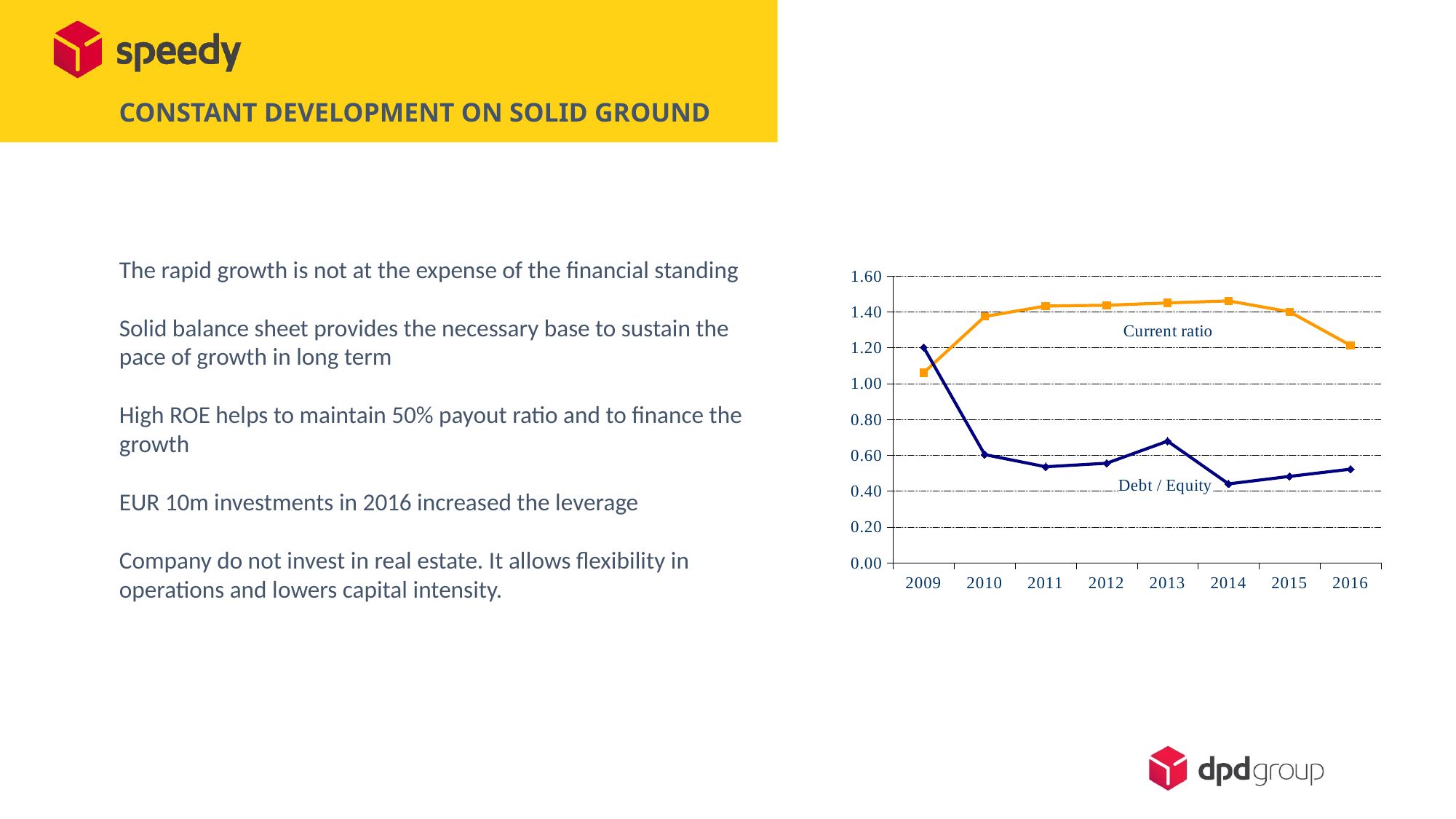
Does the Current ratio rise or fall from 2014 to 2016? Fall Is the Current ratio for 2011 greater or less than 1.40? greater In which year is the Current ratio lowest? 2009 Which series is drawn in orange on the chart? Current ratio How many series are plotted on the chart? 2 In which year is the Debt / Equity value highest? 2009 Is the Debt / Equity value for 2014 greater or less than 0.60? less How many years are shown on the x axis of the chart? 8 Is the Debt / Equity value for 2009 greater or less than 1.00? greater In 2009, which is larger: the Current ratio or Debt / Equity? Debt / Equity What kind of chart is shown on the slide? Line chart In 2010, which is larger: the Current ratio or Debt / Equity? Current ratio